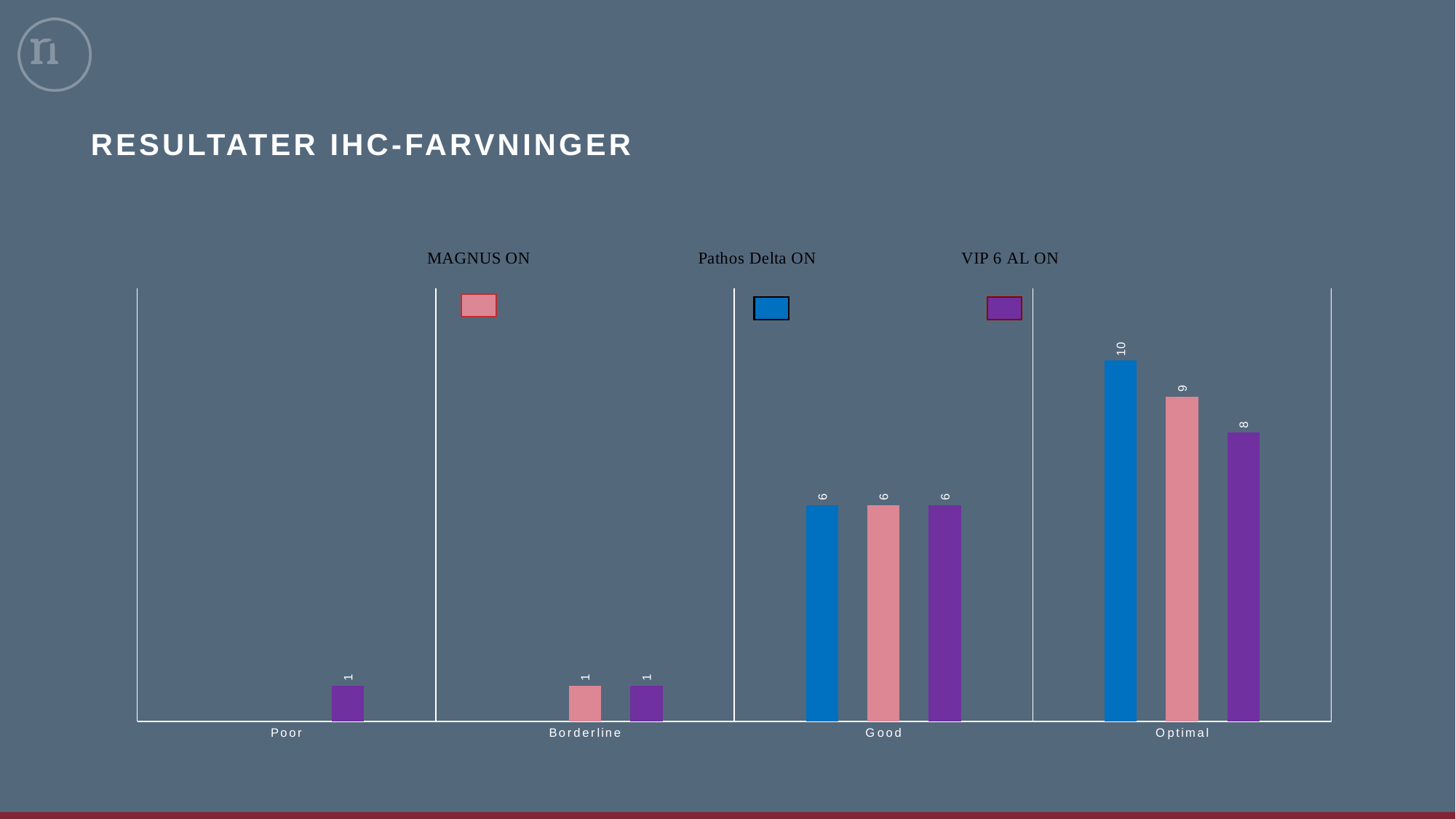
What is the value for VIP 6 AL ON in the Optimal category? 8 What is the difference between Pathos Delta ON and VIP 6 AL ON in the Optimal category? 2 How many series does the legend list? 3 What kind of chart is shown on the slide? Bar chart In the Optimal category, which is larger: MAGNUS ON or VIP 6 AL ON? MAGNUS ON How many categories are shown on the x axis? 4 What is the value for MAGNUS ON in the Good category? 6 Which series has the highest value in the Optimal category? Pathos Delta ON What is the value for VIP 6 AL ON in the Poor category? 1 What is the value for Pathos Delta ON in the Optimal category? 10 What is the value for MAGNUS ON in the Optimal category? 9